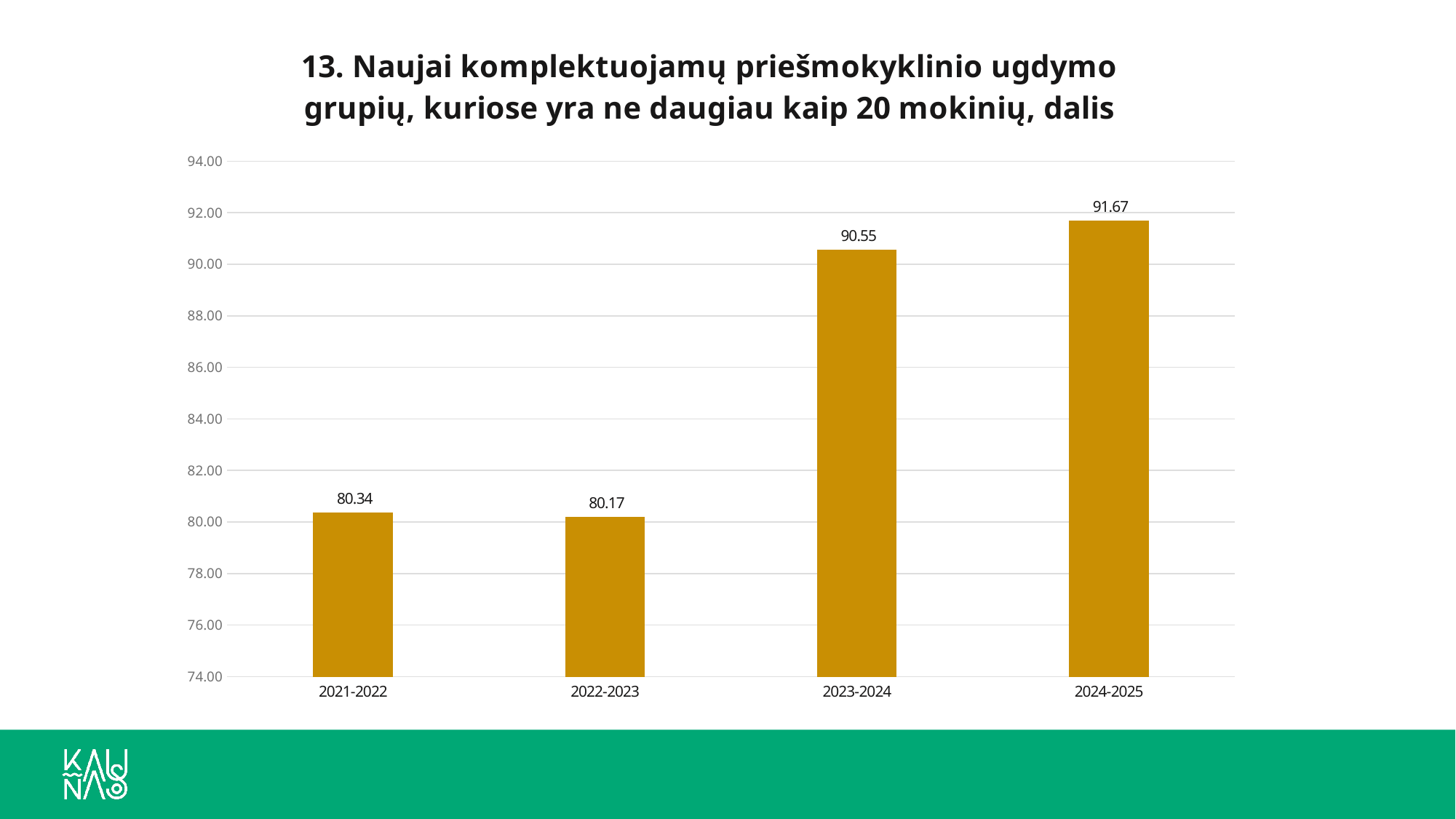
What is the value for 2022-2023? 80.17 Is the value for 2023-2024 greater or less than 90.00? greater What is the value for 2021-2022? 80.34 What is the value for 2024-2025? 91.67 Which school year has the highest value? 2024-2025 What is the difference between the values for 2024-2025 and 2023-2024? 1.12 How many school years are shown on the chart? 4 Which school year has the lowest value? 2022-2023 What kind of chart is shown on the slide? bar chart What is the difference between the values for 2023-2024 and 2022-2023? 10.38 Which is larger, the value for 2021-2022 or the value for 2023-2024? 2023-2024 What is the value for 2023-2024? 90.55